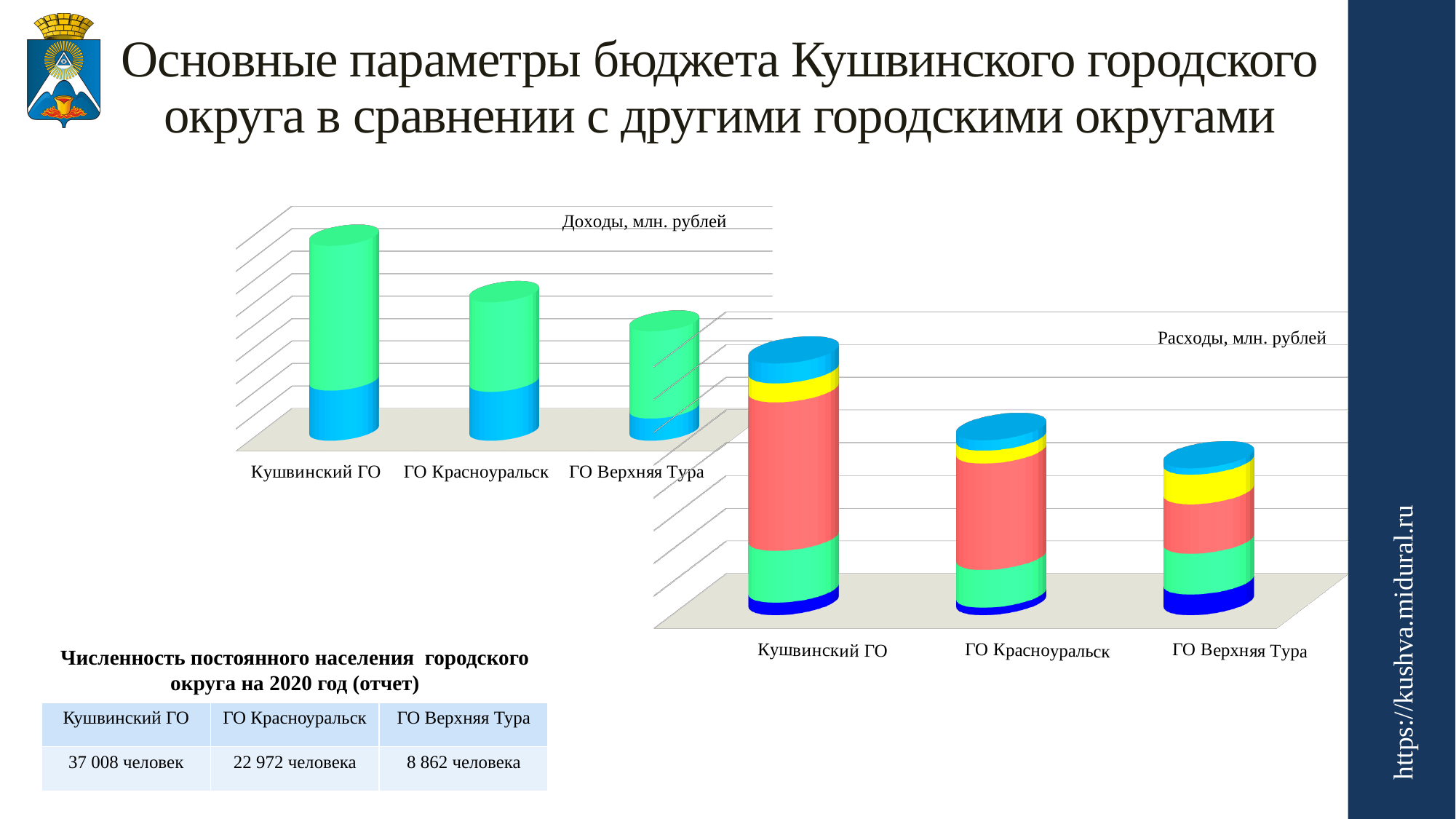
How many coloured segments make up each bar in the 'Расходы, млн. рублей' chart? 5 In the 'Расходы, млн. рублей' chart, do the bar heights rise or fall from left to right? Fall How many categories are shown in the 'Доходы, млн. рублей' chart? 3 What kind of chart is the 'Доходы, млн. рублей' chart? Bar chart In the 'Доходы, млн. рублей' chart, which category has the lowest bar? ГО Верхняя Тура In the 'Доходы, млн. рублей' chart, which is larger: the bar for ГО Красноуральск or the bar for ГО Верхняя Тура? ГО Красноуральск In the 'Расходы, млн. рублей' chart, which category has the lowest bar? ГО Верхняя Тура What is the title of the chart on the left of the slide? Доходы, млн. рублей In the 'Доходы, млн. рублей' chart, which category has the highest bar? Кушвинский ГО How many categories are shown in the 'Расходы, млн. рублей' chart? 3 What kind of chart is the 'Расходы, млн. рублей' chart? Bar chart In the 'Расходы, млн. рублей' chart, which category has the highest bar? Кушвинский ГО